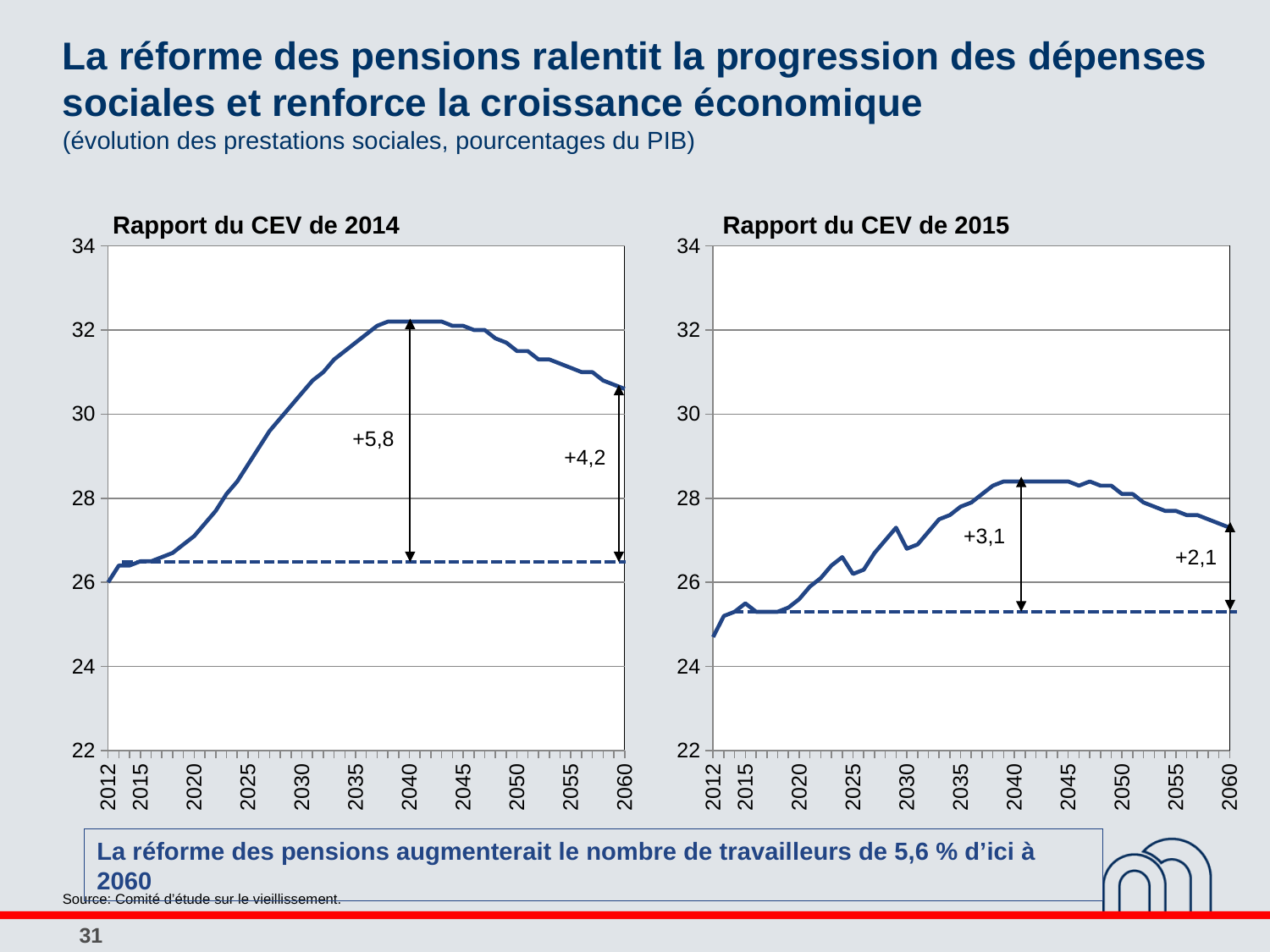
In the 'Rapport du CEV de 2015' chart, is the value for 2012 greater or less than 26? less In the 'Rapport du CEV de 2015' chart, is the value for 2060 greater or less than 28? less In the 'Rapport du CEV de 2014' chart, is the value for 2060 greater or less than 30? greater What kind of chart is the 'Rapport du CEV de 2014' chart? line chart In the 'Rapport du CEV de 2015' chart, what increase is annotated at the peak around 2040? +3,1 In the 'Rapport du CEV de 2014' chart, does the line rise or fall between 2012 and 2035? rise Which chart shows the larger annotated increase at 2060, 'Rapport du CEV de 2014' or 'Rapport du CEV de 2015'? Rapport du CEV de 2014 In the 'Rapport du CEV de 2015' chart, what increase is annotated at 2060? +2,1 In the 'Rapport du CEV de 2014' chart, what increase is annotated at the peak around 2040? +5,8 In the 'Rapport du CEV de 2014' chart, what increase is annotated at 2060? +4,2 What is the title of the chart on the right side of the slide? Rapport du CEV de 2015 In the 'Rapport du CEV de 2015' chart, does the line rise or fall between 2045 and 2060? fall